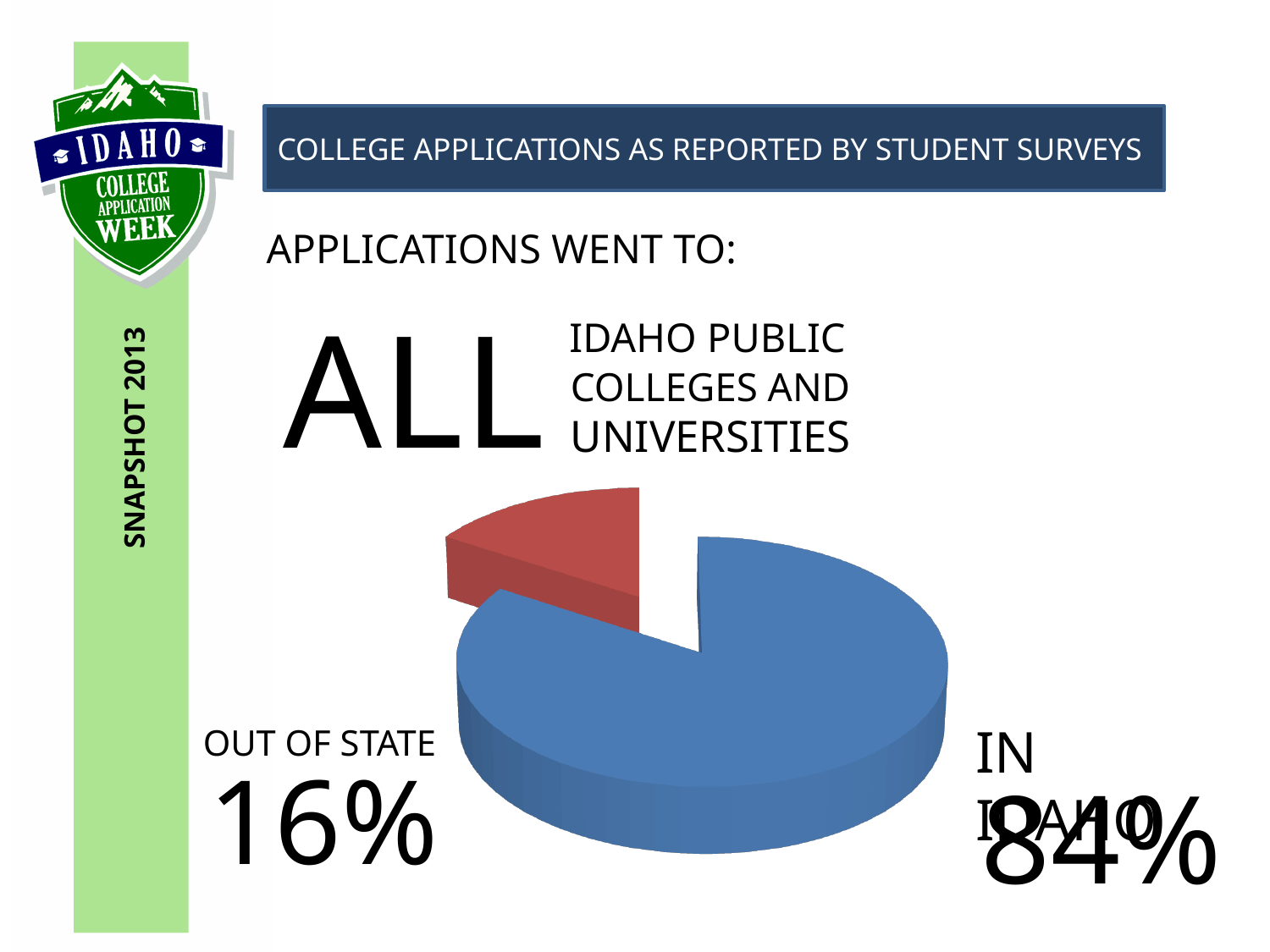
What share of applications went to colleges in Idaho? 84% What is the difference in percentage points between the In Idaho share and the Out of State share? 68 What colour is the In Idaho slice of the pie chart? blue Which is larger, the In Idaho share or the Out of State share? In Idaho What kind of chart is shown on the slide? pie chart How many slices does the pie chart have? 2 What do the two slices of the pie chart add up to? 100% What colour is the Out of State slice of the pie chart? red What share of applications went out of state? 16% Which slice of the pie chart is the smallest? Out of State Which slice of the pie chart is the largest? In Idaho Is the Out of State share greater or less than 50%? less